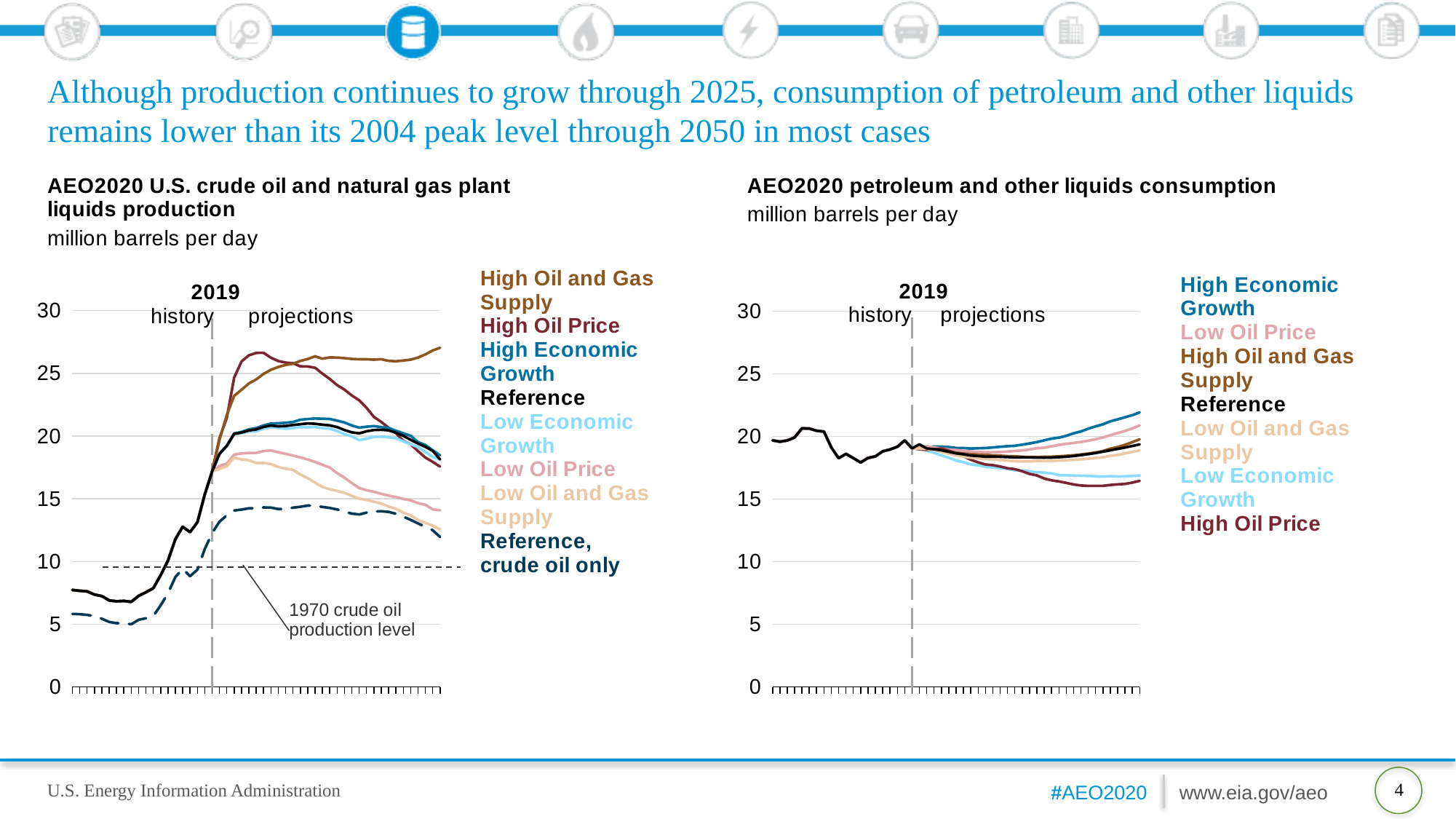
In the right chart (consumption), which series is highest at the end of the projection period? High Economic Growth In the right chart (consumption), which series is lowest at the end of the projection period? High Oil Price How many series does the legend of the left chart (crude oil and natural gas plant liquids production) list? 8 In the left chart (production), which series is highest at the end of the projection period? High Oil and Gas Supply What unit is used on the y axis of both charts? million barrels per day How many series does the legend of the right chart (petroleum and other liquids consumption) list? 7 In the left chart (production), is the value for Reference, crude oil only at the end of the projection period greater or less than 15? less In the left chart (production), is the value for High Oil and Gas Supply at the end of the projection period greater or less than 25? greater In the left chart (production), what does the horizontal dashed line represent? 1970 crude oil production level What kind of chart is the AEO2020 U.S. crude oil and natural gas plant liquids production chart on the left? line chart In the right chart (consumption), is the value for High Oil Price at the end of the projection period greater or less than 20? less In the right chart (consumption), does the High Oil Price series rise or fall over the projection period? fall